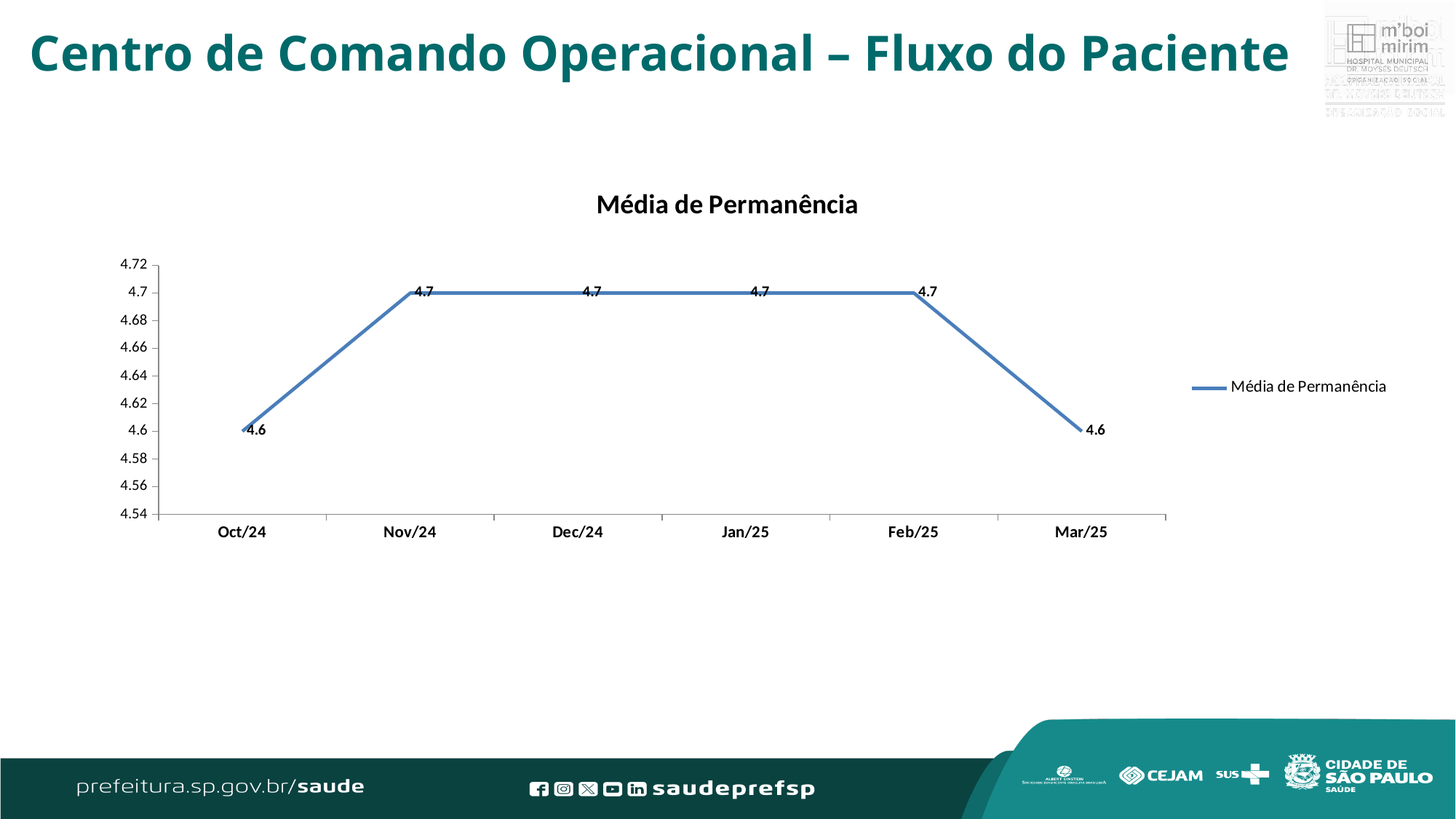
Is the value for Dec/24 greater or less than 4.64? greater What is the difference between the values for Nov/24 and Oct/24? 0.1 How many series does the legend list? 1 What is the value for Oct/24? 4.6 How many months are plotted on the x axis? 6 What is the value for Mar/25? 4.6 Is the value for Oct/24 greater or less than 4.64? less What is the title of the chart? Média de Permanência What kind of chart is shown? line chart Which is larger, the value for Feb/25 or the value for Mar/25? Feb/25 What is the value for Jan/25? 4.7 What is the value for Nov/24? 4.7